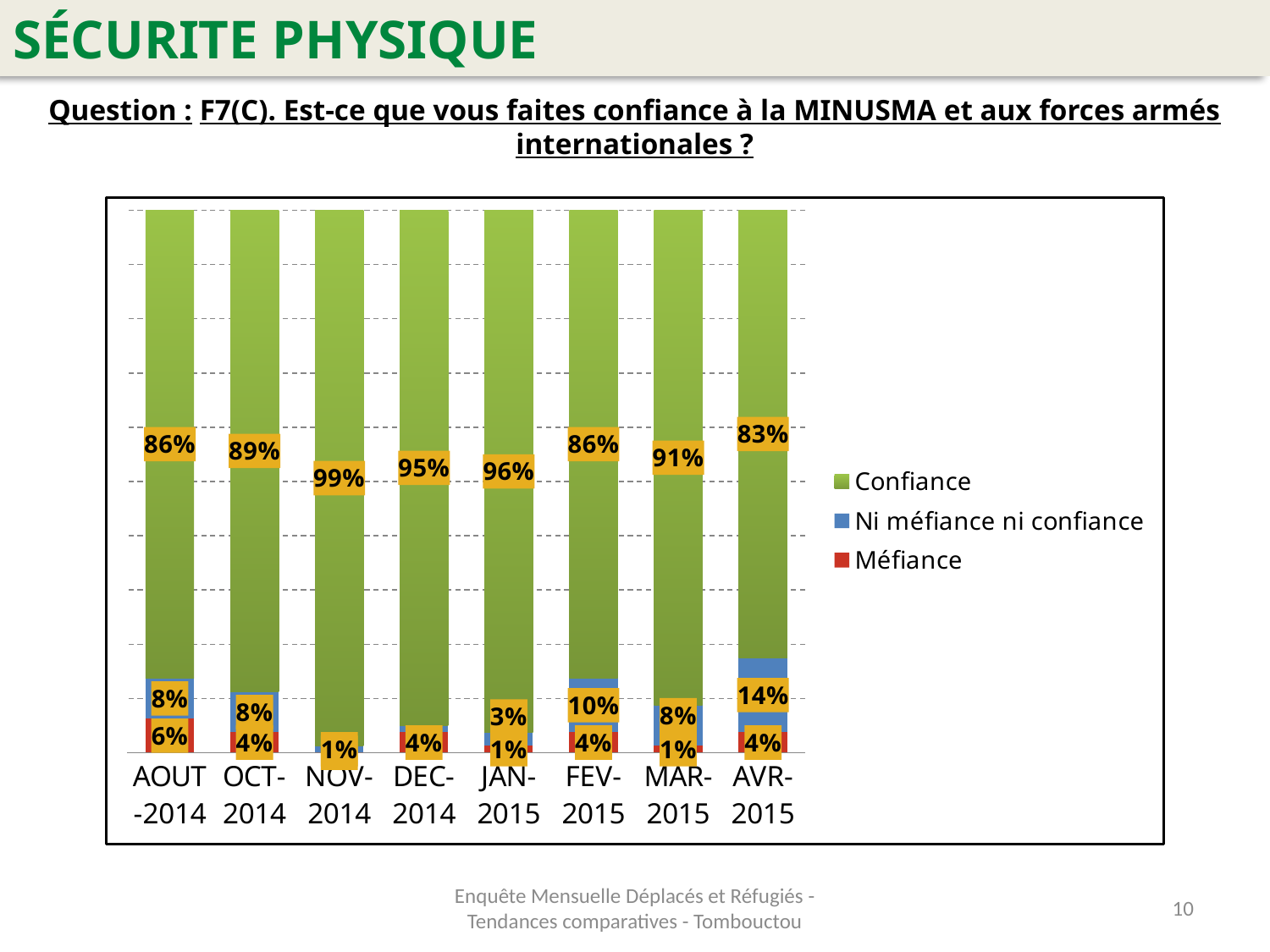
Which month has the lowest Confiance value? AVR-2015 What is the difference between the Confiance values for OCT-2014 and AVR-2015? 6 percentage points What kind of chart is shown on the slide? Stacked bar chart What is the Méfiance value for AOUT-2014? 6% Which month has the highest Confiance value? NOV-2014 How many series does the legend list? 3 How many months are shown on the x axis? 8 Which month has the highest Ni méfiance ni confiance value? AVR-2015 What is the Confiance value for NOV-2014? 99% What is the Confiance value for AVR-2015? 83% What is the Ni méfiance ni confiance value for FEV-2015? 10% Which is larger, the Confiance value for DEC-2014 or for JAN-2015? JAN-2015